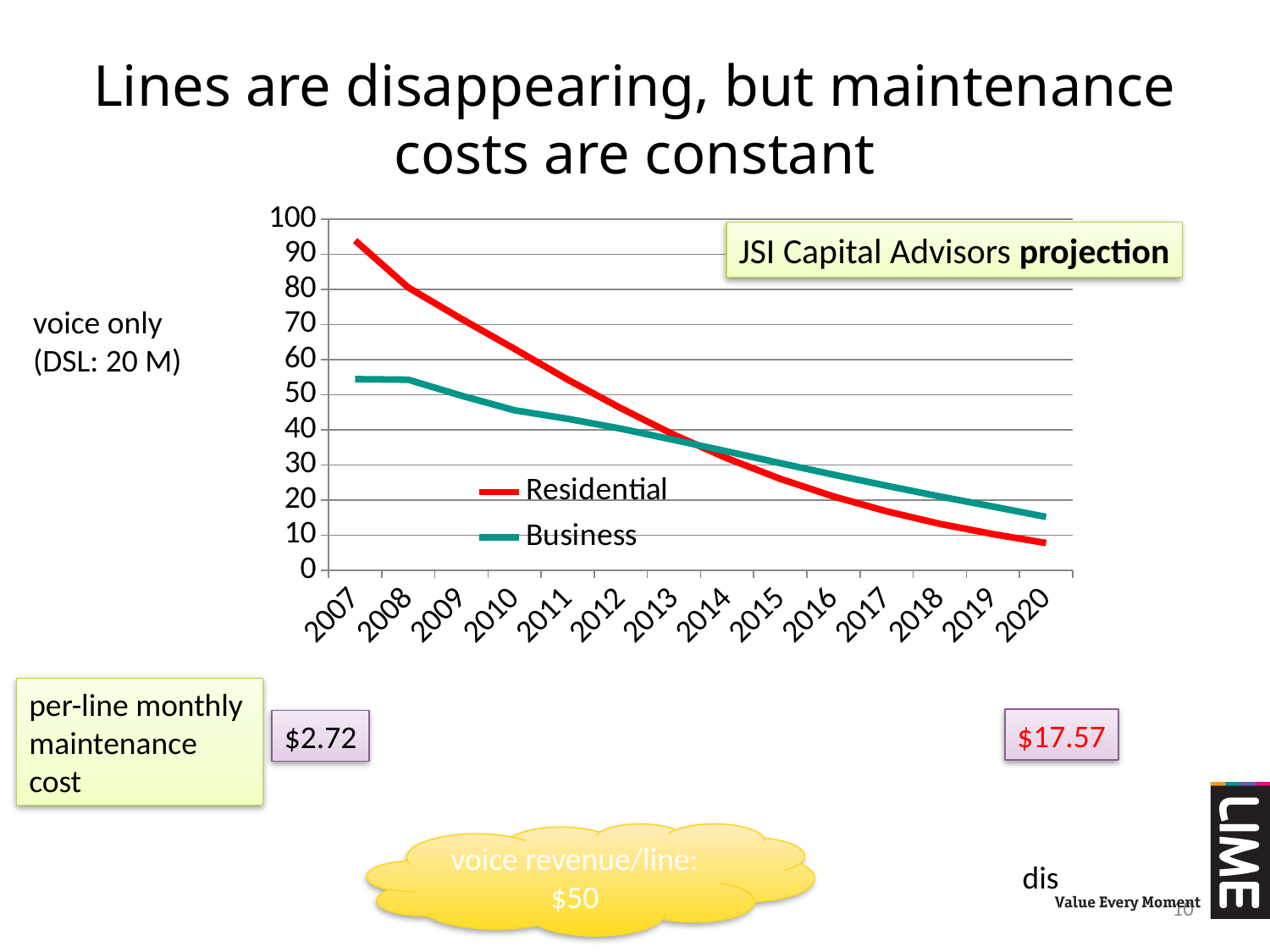
Is the Residential value for 2007 greater or less than 80? greater How many years are shown along the x axis of the chart? 14 How many series does the chart legend list? 2 In 2007, which series has the higher value, Residential or Business? Residential Is the Business value for 2018 greater or less than 30? less What kind of chart is shown on the slide? line chart Does the Residential line rise or fall from 2007 to 2020? fall Which colour is used for the Residential line in the chart? red Does the Business line rise or fall from 2007 to 2020? fall In 2020, which series has the higher value, Residential or Business? Business Is the Residential value for 2020 greater or less than 20? less